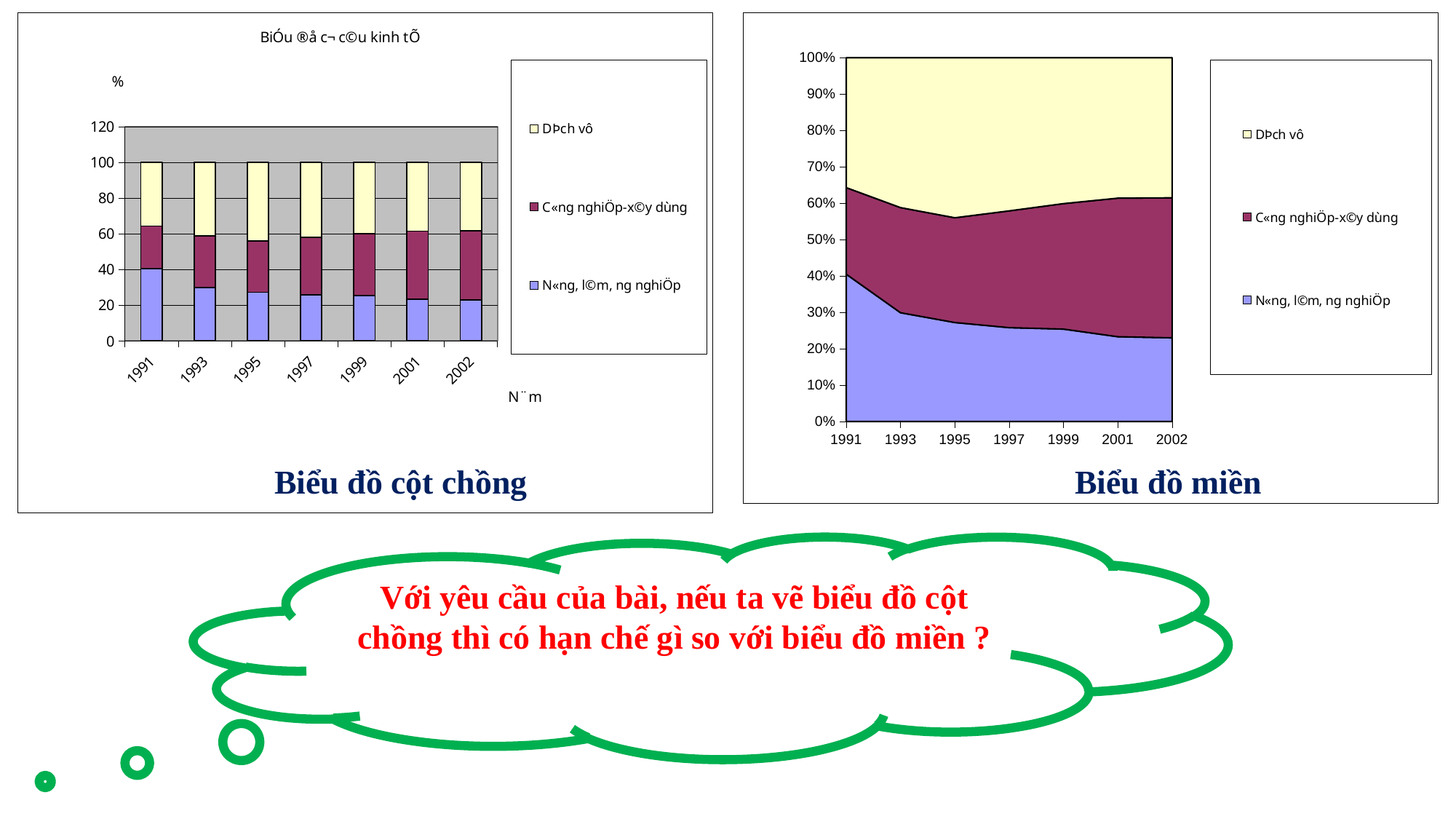
In the left chart (Biểu đồ cột chồng), which is larger for the bottom series "N«ng, l©m, ng nghiÖp": 1991 or 1993? 1991 In the left chart (Biểu đồ cột chồng), how many years are shown on the x axis? 7 In the left chart (Biểu đồ cột chồng), which year has the highest value for the bottom series "N«ng, l©m, ng nghiÖp"? 1991 In the right chart (Biểu đồ miền), does the bottom series "N«ng, l©m, ng nghiÖp" rise or fall from 1991 to 2002? fall In the left chart (Biểu đồ cột chồng), what is the total height of the stacked bar for 1991? 100 What kind of chart is the left chart, captioned "Biểu đồ cột chồng"? bar chart In the right chart (Biểu đồ miền), how many series does the legend list? 3 In the right chart (Biểu đồ miền), is the value of the bottom series "N«ng, l©m, ng nghiÖp" for 2002 greater or less than 30%? less In the left chart (Biểu đồ cột chồng), what label is shown on the vertical axis? % In the left chart (Biểu đồ cột chồng), is the value of the bottom series "N«ng, l©m, ng nghiÖp" for 2002 greater or less than 40? less What kind of chart is the right chart, captioned "Biểu đồ miền"? area chart In the right chart (Biểu đồ miền), what is the first year shown on the x axis? 1991